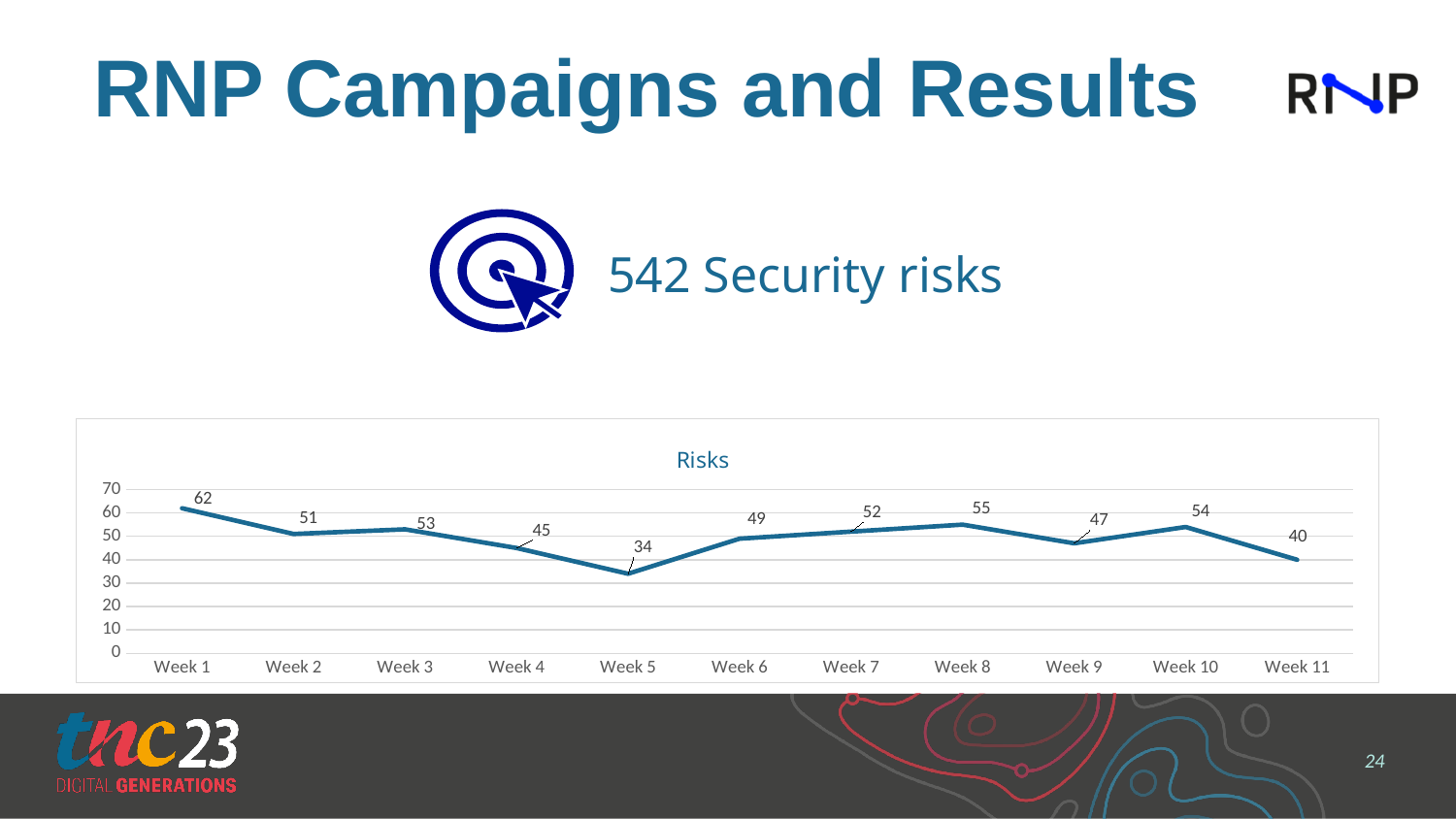
Which week has the lowest value in the Risks chart? Week 5 What is the value for Week 5 in the Risks chart? 34 What is the difference between the values for Week 1 and Week 5 in the Risks chart? 28 Which is larger in the Risks chart, the value for Week 8 or the value for Week 9? Week 8 How many weeks are plotted in the Risks chart? 11 What kind of chart is the Risks chart? line chart In the Risks chart, does the value rise or fall from Week 5 to Week 6? rise What is the value for Week 1 in the Risks chart? 62 What is the value for Week 11 in the Risks chart? 40 Which week has the highest value in the Risks chart? Week 1 What is the title of the chart on the slide? Risks Is the value for Week 7 in the Risks chart greater or less than 50? greater